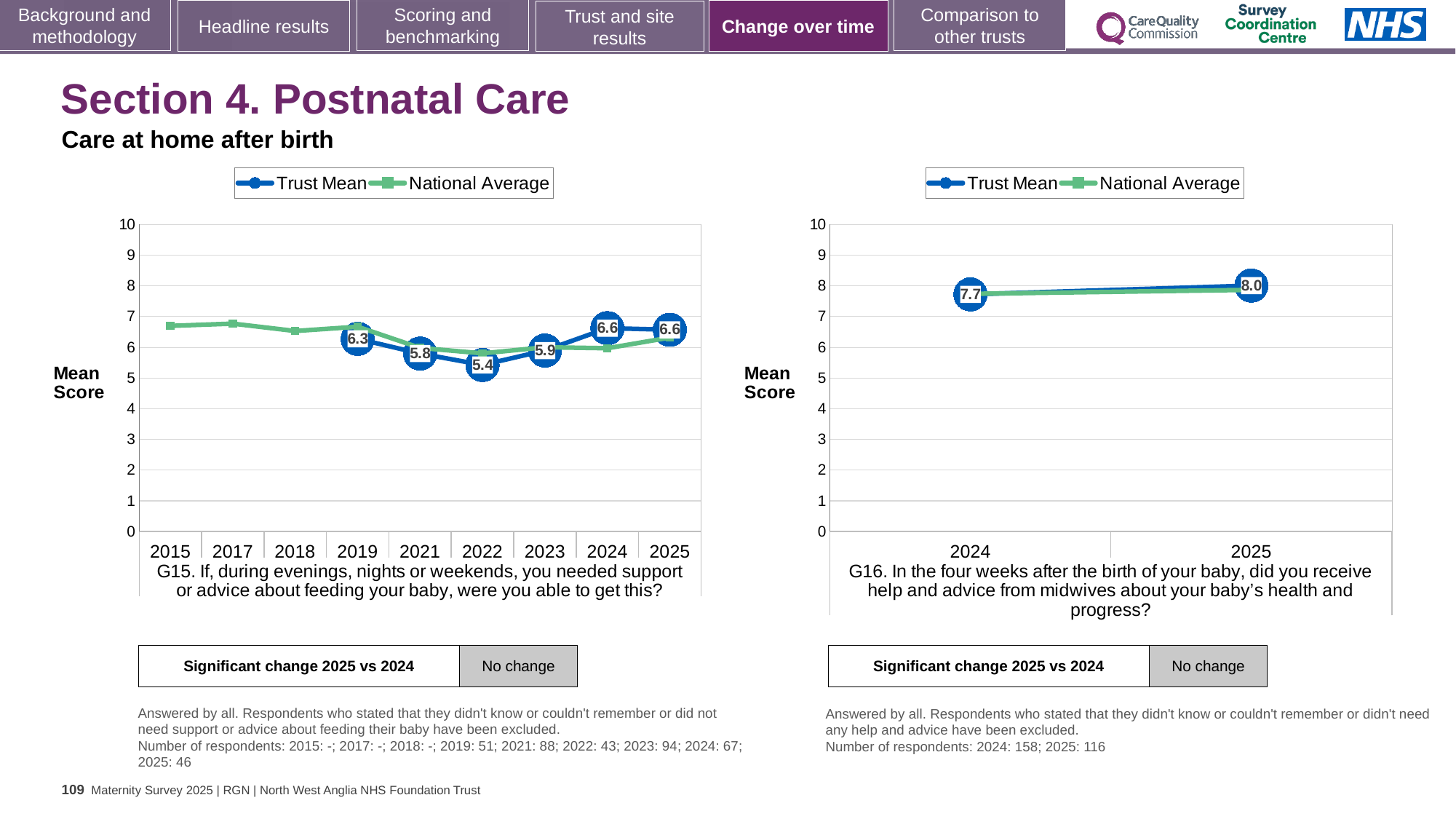
In the G16 chart on the right, does the Trust Mean rise or fall from 2024 to 2025? rise In the G15 chart on the left, is the Trust Mean for 2023 greater or less than 6? less In the G15 chart on the left, what is the Trust Mean for 2022? 5.4 In the G15 chart on the left, what is the difference between the Trust Mean for 2024 and the Trust Mean for 2022? 1.2 In the G16 chart on the right, what is the Trust Mean for 2024? 7.7 In the G16 chart on the right, what is the Trust Mean for 2025? 8.0 In the G15 chart on the left, how many years are shown on the x axis? 9 In the G15 chart on the left, which year has the lowest Trust Mean? 2022 In the G15 chart on the left, what is the Trust Mean for 2019? 6.3 How many series does the legend of the G16 chart on the right list? 2 In the G16 chart on the right, which year has the higher Trust Mean, 2024 or 2025? 2025 What kind of chart is the G15 chart on the left? line chart